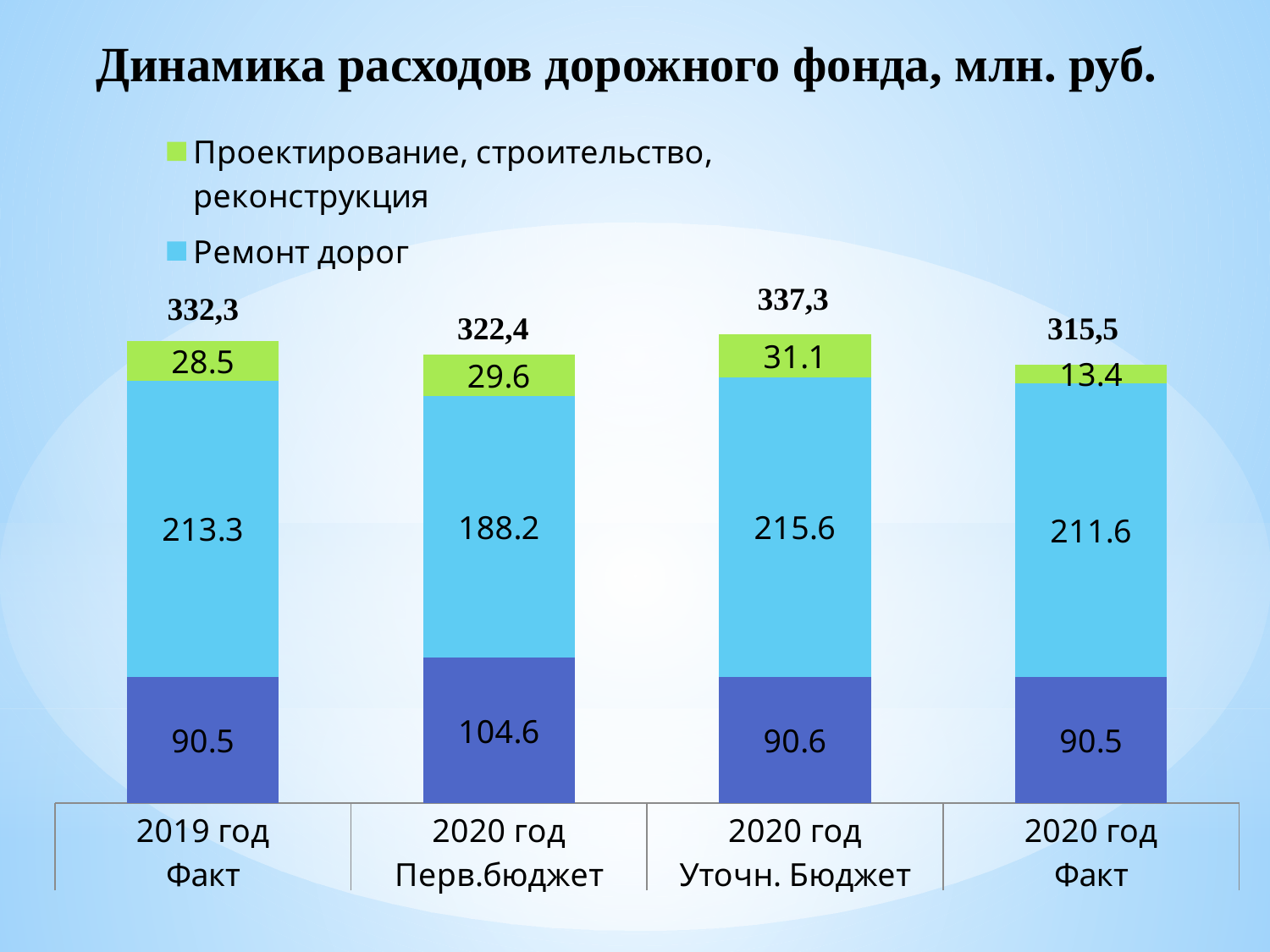
What is the value of Проектирование, строительство, реконструкция for 2020 год Уточн. Бюджет? 31.1 What kind of chart is shown on the slide? Stacked bar chart Which category has the lowest value for Проектирование, строительство, реконструкция? 2020 год Факт Which category has the highest total? 2020 год Уточн. Бюджет What is the value of Ремонт дорог for 2020 год Перв.бюджет? 188.2 What is the difference in Ремонт дорог between 2020 год Уточн. Бюджет and 2020 год Перв.бюджет? 27.4 How many categories are shown on the x axis? 4 Which is larger for Проектирование, строительство, реконструкция: 2019 год Факт or 2020 год Факт? 2019 год Факт What is the value of Ремонт дорог for 2019 год Факт? 213.3 How many series does the legend list? 2 What is the total shown above the bar for 2020 год Факт? 315,5 Which category has the lowest total? 2020 год Факт